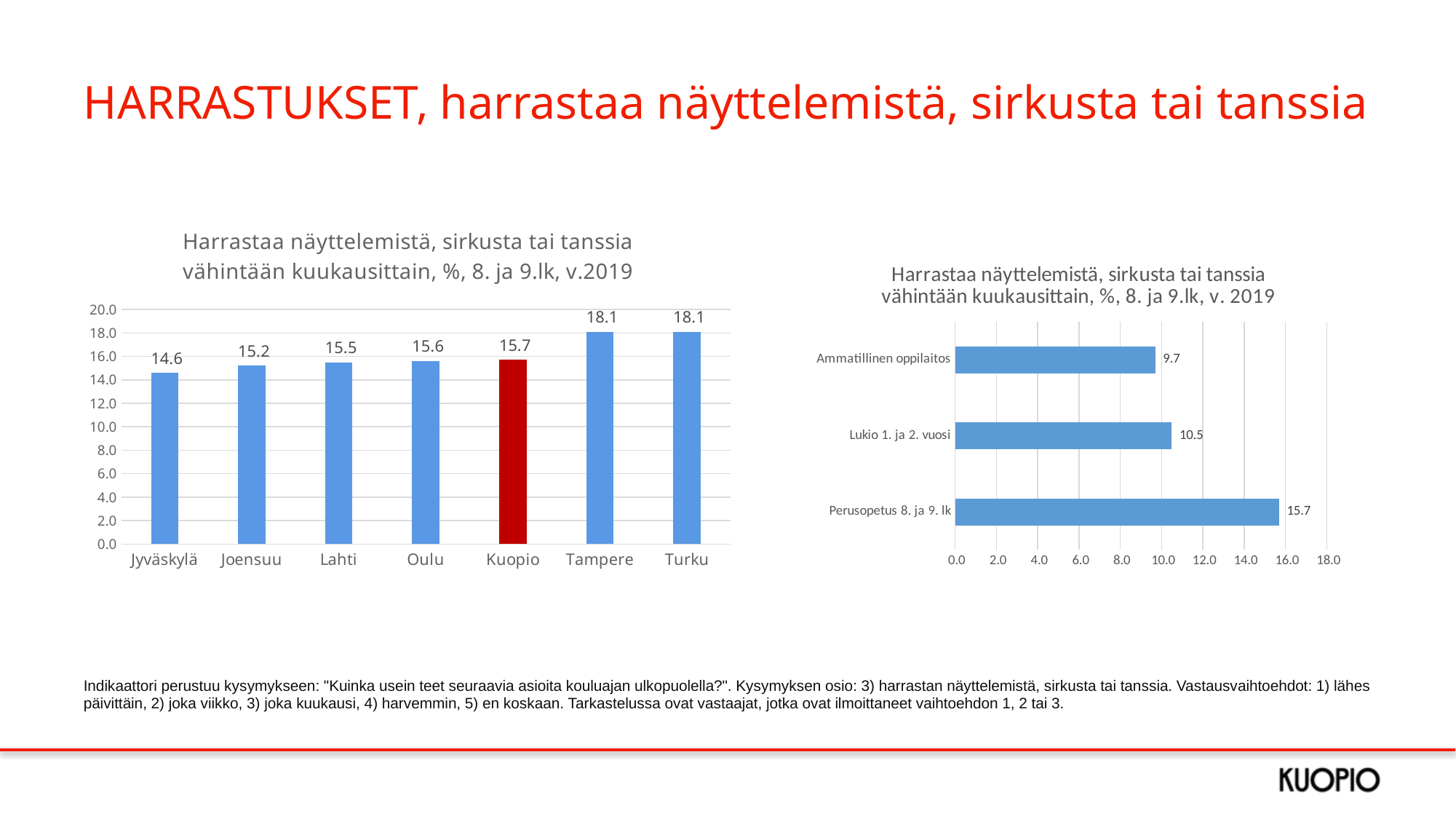
In the right chart, what is the difference between Perusopetus 8. ja 9. lk and Ammatillinen oppilaitos? 6.0 In the right chart, what is the value for Lukio 1. ja 2. vuosi? 10.5 In the left chart, which city has the lowest value? Jyväskylä In the right chart, how many categories are shown? 3 In the left chart, what is the value for Kuopio? 15.7 In the left chart, how many cities are shown? 7 In the left chart, which bar is coloured red? Kuopio In the right chart, which category has the highest value? Perusopetus 8. ja 9. lk In the left chart, what is the value for Jyväskylä? 14.6 In the left chart, what is the difference between Turku and Jyväskylä? 3.5 What type of chart is the right chart? Bar chart In the left chart, which is larger, Oulu or Joensuu? Oulu